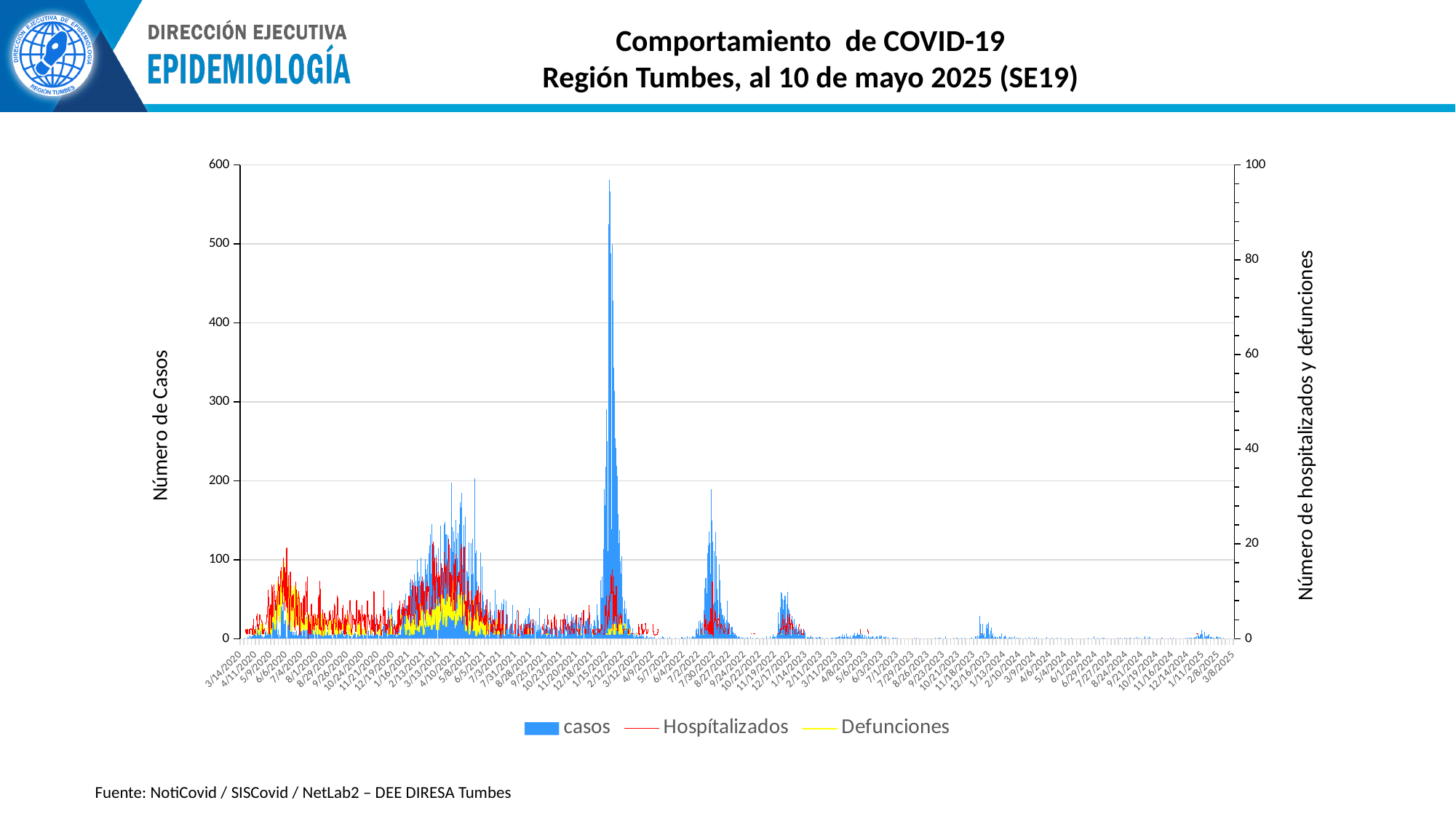
What is the title of the chart? Comportamiento de COVID-19 Región Tumbes, al 10 de mayo 2025 (SE19) Is the peak of casos around 12/17/2022 greater or less than 100? less Is the highest peak of casos greater or less than 500? greater What is the maximum value shown on the left vertical axis? 600 What is the maximum value shown on the right vertical axis? 100 Which is larger, the casos peak in early 2022 or the casos peak in mid 2022? early 2022 What kind of chart is shown on the slide? bar and line chart Is the peak of casos around 7/30/2022 greater or less than 200? less Which series is plotted as bars? casos How many series does the legend list? 3 Between which two x-axis dates does the highest casos peak occur? 1/15/2022 and 2/12/2022